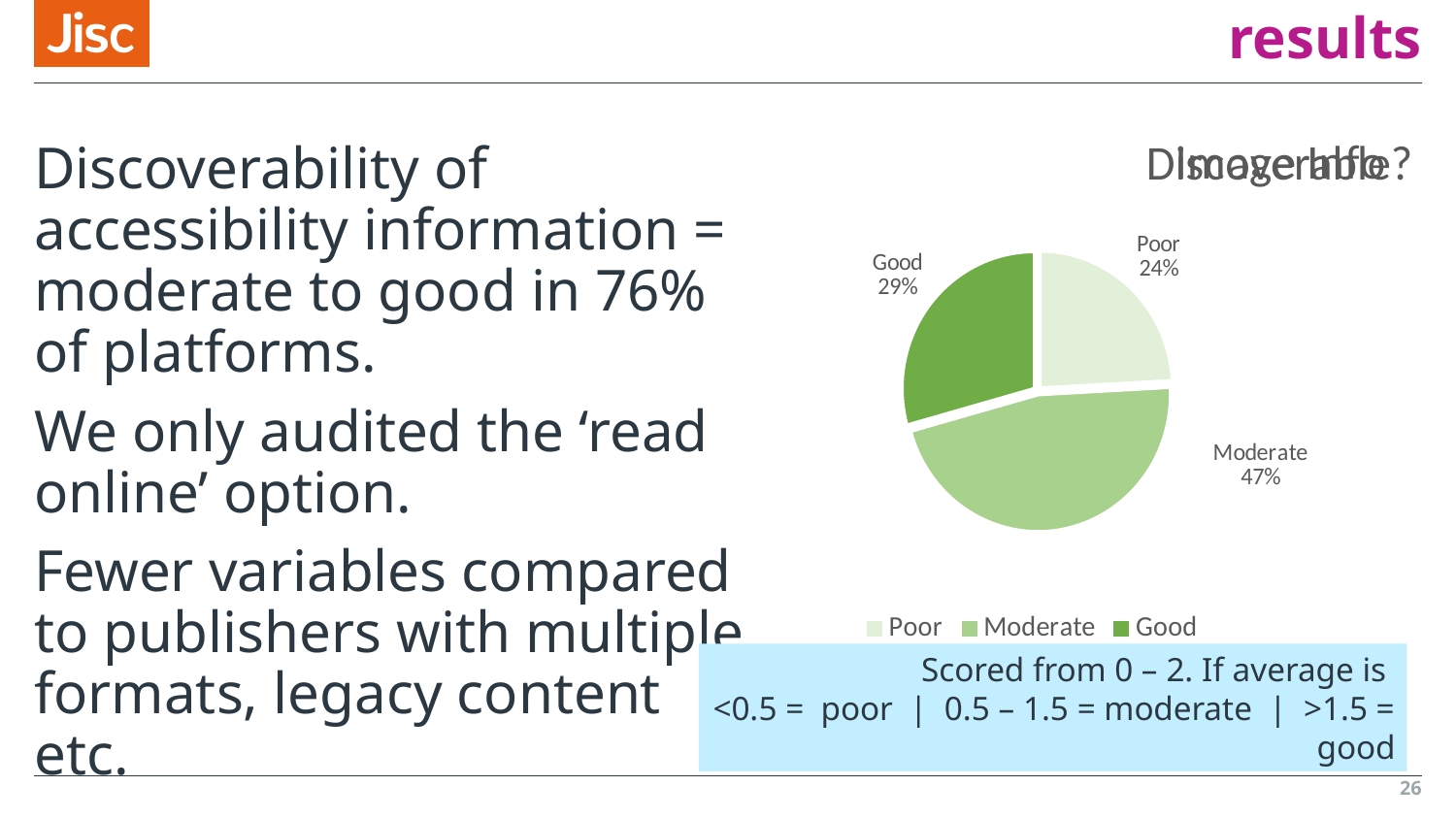
What percentage of the pie chart is labelled Moderate? 47% What type of chart is shown on the slide? Pie chart What percentage of the pie chart is labelled Poor? 24% How many categories are shown in the pie chart? 3 Which slice is larger, Good or Poor? Good What is the difference in percentage points between the Moderate and Poor slices? 23 Which category has the largest slice of the pie chart? Moderate Which category has the smallest slice of the pie chart? Poor What colour is the Good slice in the pie chart? Dark green What is the difference in percentage points between the Good and Poor slices? 5 What percentage of the pie chart is labelled Good? 29% What is the combined share of the Moderate and Good slices? 76%